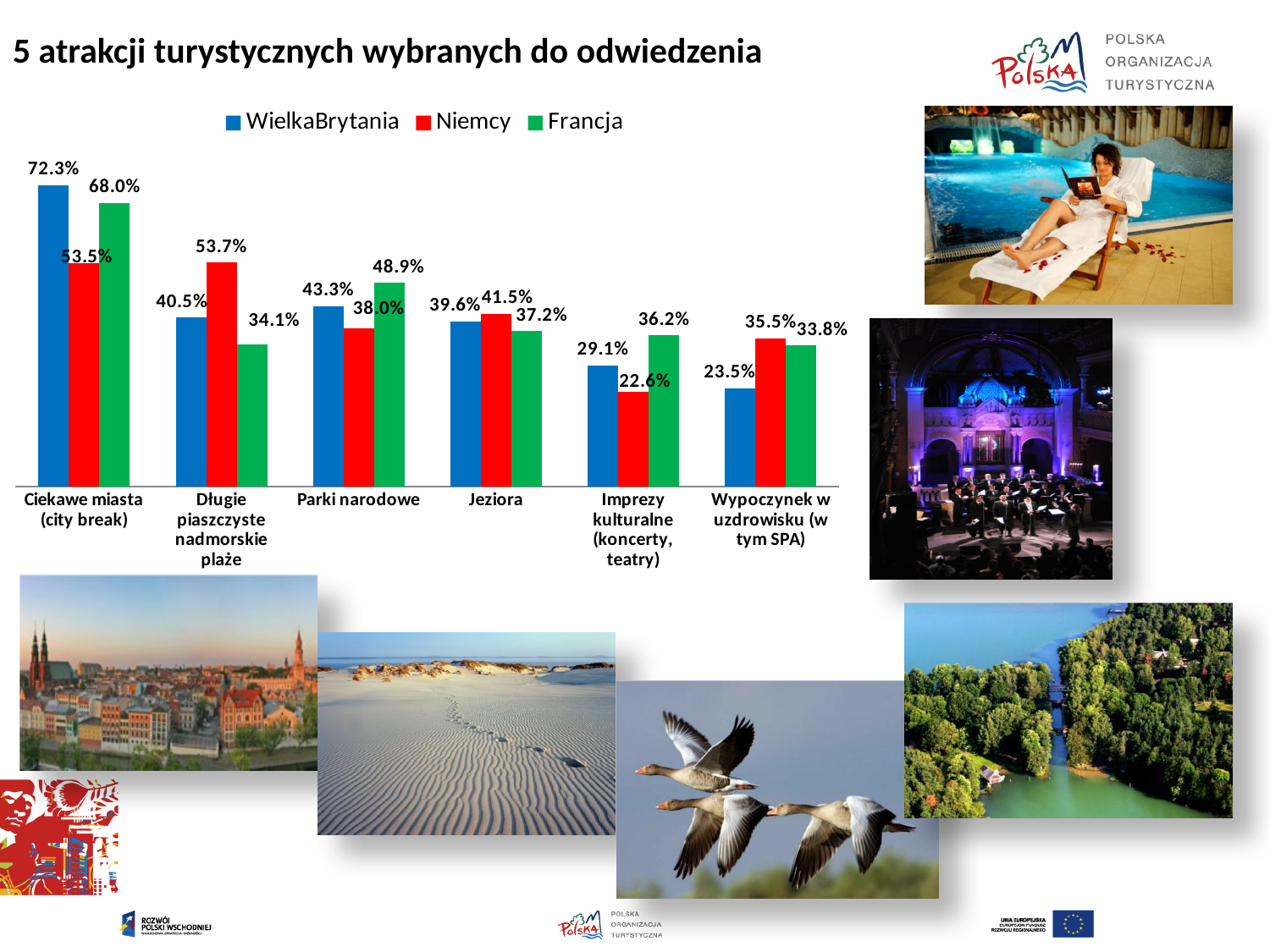
What kind of chart is shown on the slide? bar chart What is the value for Francja in the category Parki narodowe? 48.9% What is the value for WielkaBrytania in the category Ciekawe miasta (city break)? 72.3% Which is larger for Wypoczynek w uzdrowisku (w tym SPA): the value for WielkaBrytania or the value for Niemcy? Niemcy Which colour represents the Francja series in the chart? green What is the difference between the WielkaBrytania and Francja values for Ciekawe miasta (city break)? 4.3% Which category has the highest value for WielkaBrytania? Ciekawe miasta (city break) What is the value for Niemcy in the category Długie piaszczyste nadmorskie plaże? 53.7% What is the value for Niemcy in the category Imprezy kulturalne (koncerty, teatry)? 22.6% How many categories are shown on the x axis of the chart? 6 Which category has the lowest value for Niemcy? Imprezy kulturalne (koncerty, teatry) How many series does the chart legend list? 3